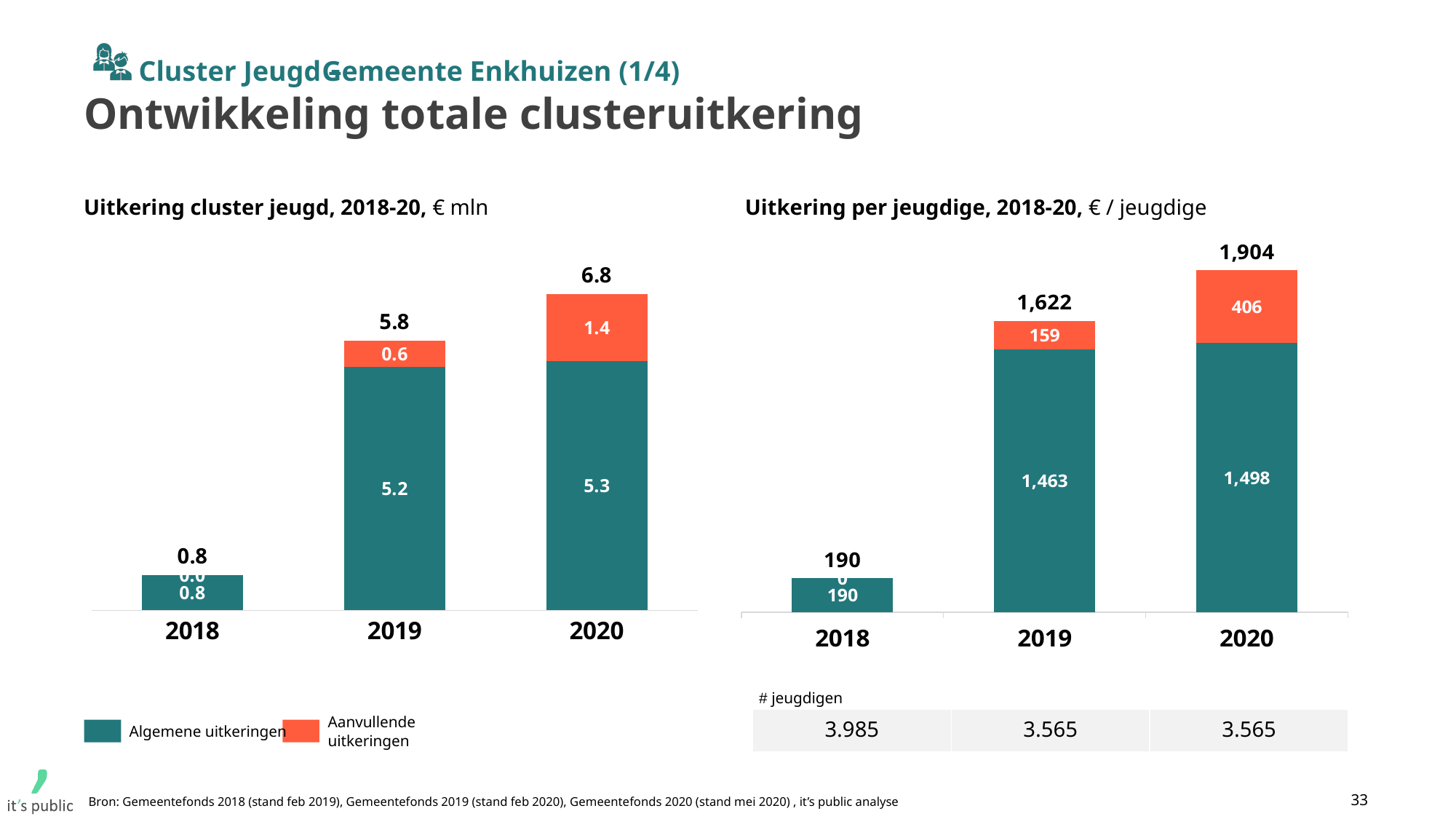
In the left chart 'Uitkering cluster jeugd, 2018-20', what is the difference between the totals for 2020 and 2019? 1.0 What kind of chart is the left chart 'Uitkering cluster jeugd, 2018-20'? Stacked bar chart In the left chart 'Uitkering cluster jeugd, 2018-20', what is the value of Algemene uitkeringen for 2019? 5.2 In the right chart 'Uitkering per jeugdige, 2018-20', what is the value of Aanvullende uitkeringen for 2019? 159 In the left chart 'Uitkering cluster jeugd, 2018-20', what is the total for 2020? 6.8 In the left chart 'Uitkering cluster jeugd, 2018-20', what is the value of Aanvullende uitkeringen for 2020? 1.4 In the right chart 'Uitkering per jeugdige, 2018-20', what is the total for 2020? 1,904 In the right chart 'Uitkering per jeugdige, 2018-20', what is the difference between the totals for 2019 and 2018? 1,432 In the right chart 'Uitkering per jeugdige, 2018-20', which year has the highest total? 2020 In the right chart 'Uitkering per jeugdige, 2018-20', what is the value of Algemene uitkeringen for 2020? 1,498 How many series does the legend list for the left chart? 2 In the left chart 'Uitkering cluster jeugd, 2018-20', which year has the lowest total? 2018